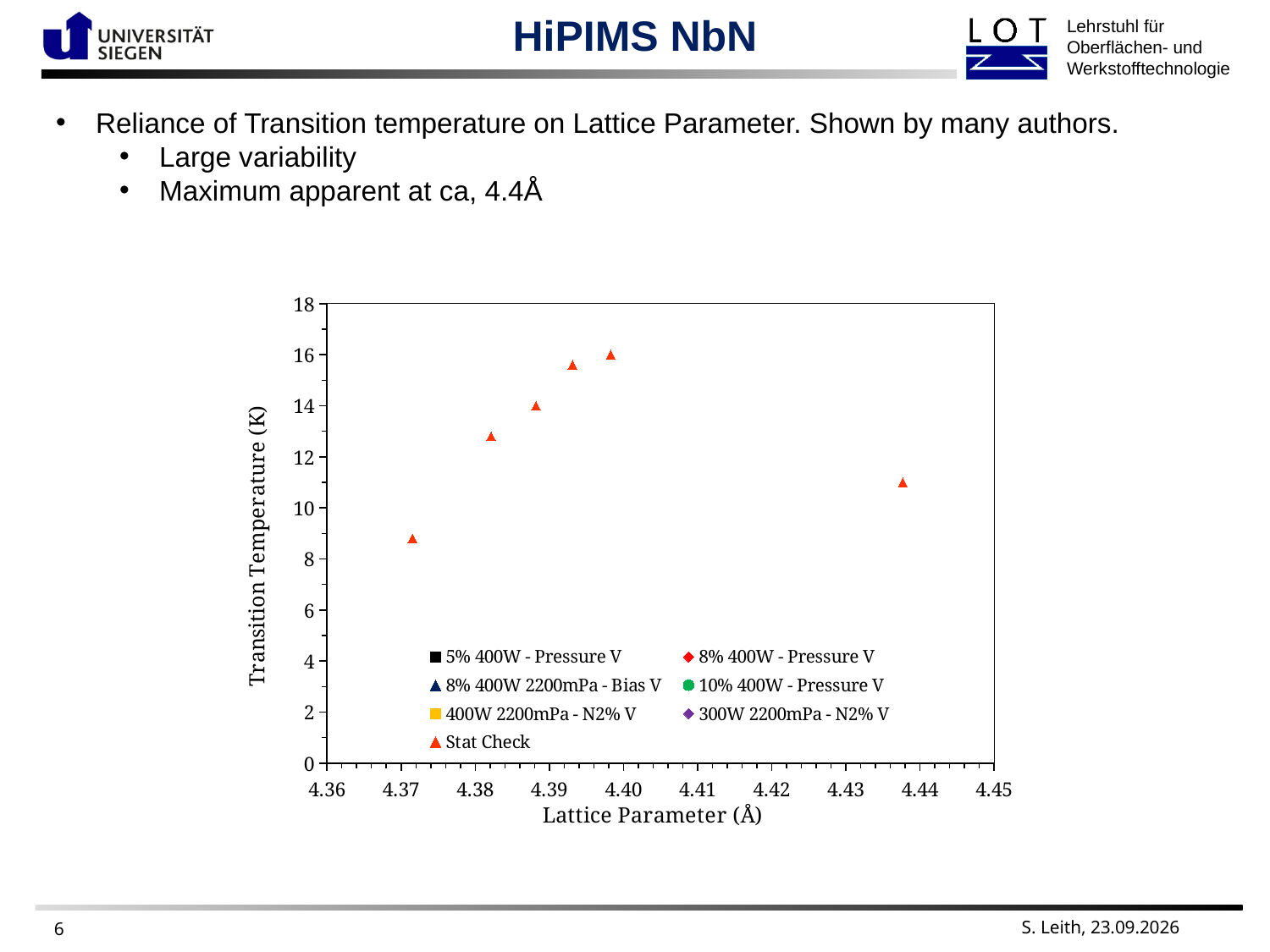
Is the transition temperature of the point at a lattice parameter of about 4.44 Å greater or less than 10? greater Do the transition temperatures rise or fall as the lattice parameter increases from 4.37 Å to 4.40 Å? rise Which point has the higher transition temperature: the one at about 4.37 Å or the one at about 4.44 Å? the one at about 4.44 Å How many data points are plotted on the chart? 6 Which point has the lower transition temperature: the one at about 4.39 Å or the one at about 4.44 Å? the one at about 4.44 Å Is the transition temperature of the point at a lattice parameter of about 4.40 Å greater or less than 14? greater Is the transition temperature of the point at a lattice parameter of about 4.37 Å greater or less than 10? less How many series does the chart legend list? 7 What kind of chart is shown on the slide? scatter chart Which legend series do the plotted orange triangle points belong to? Stat Check What is the title of the y axis? Transition Temperature (K)